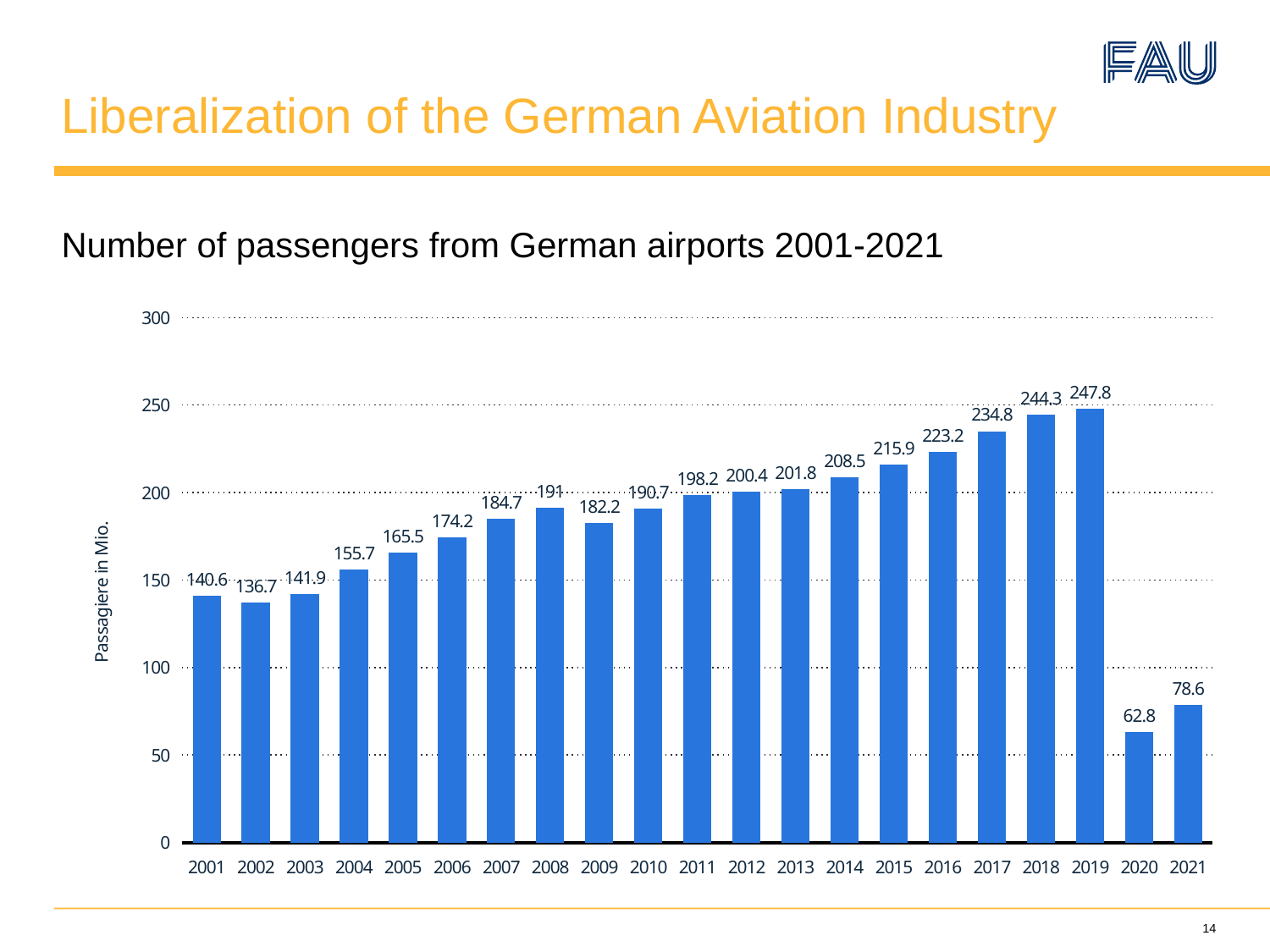
Is the value for 2021 greater or less than 100? less What is the number of passengers (in Mio.) for 2001? 140.6 Which year has the highest number of passengers? 2019 What kind of chart is shown on the slide? bar chart Do the values generally rise or fall from 2010 to 2019? rise How many years are shown on the x axis? 21 What is the number of passengers (in Mio.) for 2019? 247.8 What is the difference in passengers (in Mio.) between 2019 and 2020? 185 What is the label of the y axis? Passagiere in Mio. Which year has the lowest number of passengers? 2020 Which year had more passengers, 2009 or 2010? 2010 What is the number of passengers (in Mio.) for 2020? 62.8